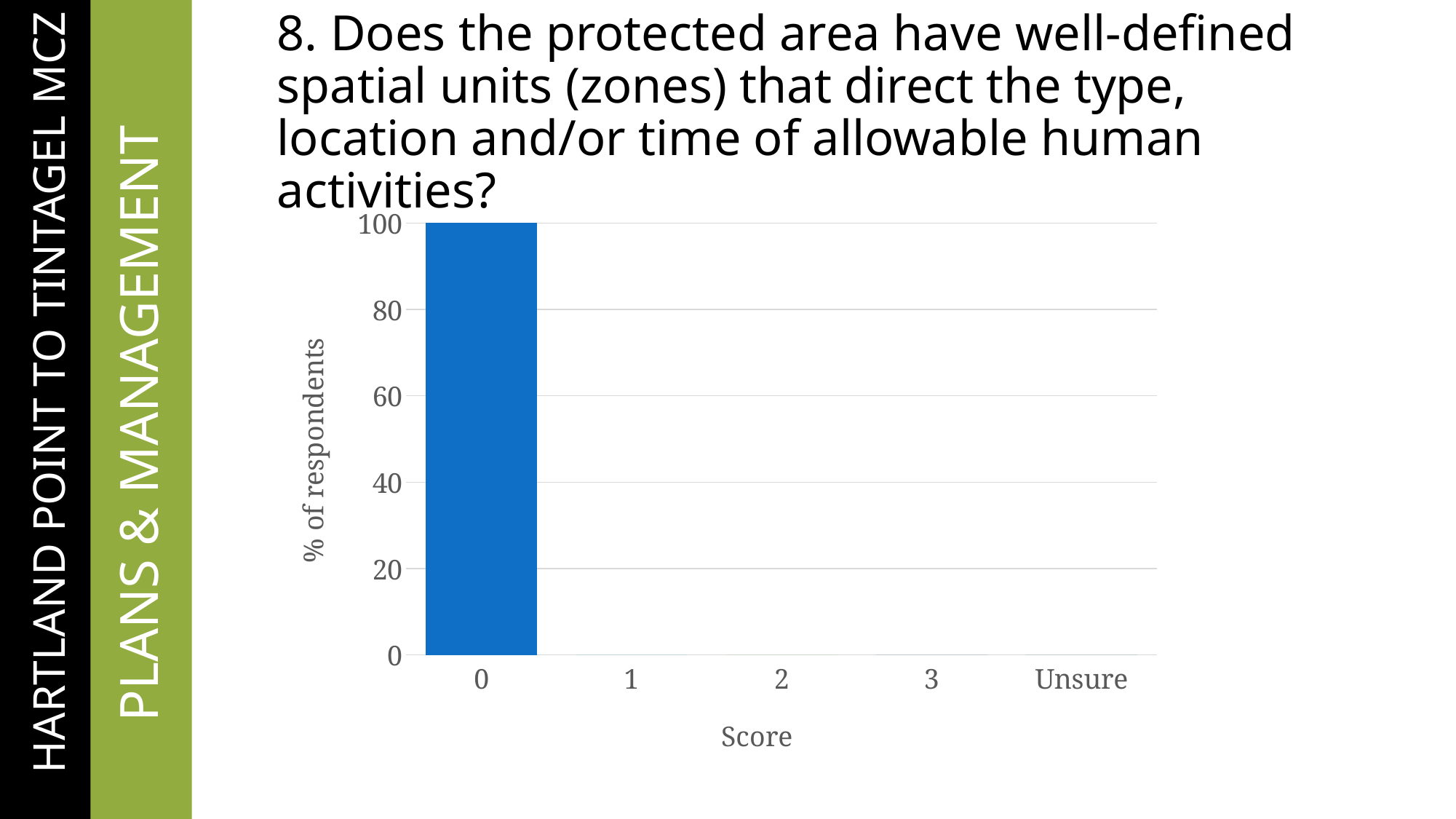
What is the label of the x axis of the chart? Score Is the value for score 0 greater or less than 80? greater What is the difference between the % of respondents for score 0 and for score 1? 100 What is the label of the y axis of the chart? % of respondents Do the values rise or fall from score 0 to score 1 along the x axis? fall How many score categories are shown on the x axis of the chart? 5 Which is larger, the % of respondents for score 0 or for score 3? score 0 What is the % of respondents for score 0? 100 Which score category has the highest % of respondents? 0 What kind of chart is shown on the slide? bar chart What is the % of respondents for the Unsure category? 0 What is the % of respondents for score 2? 0